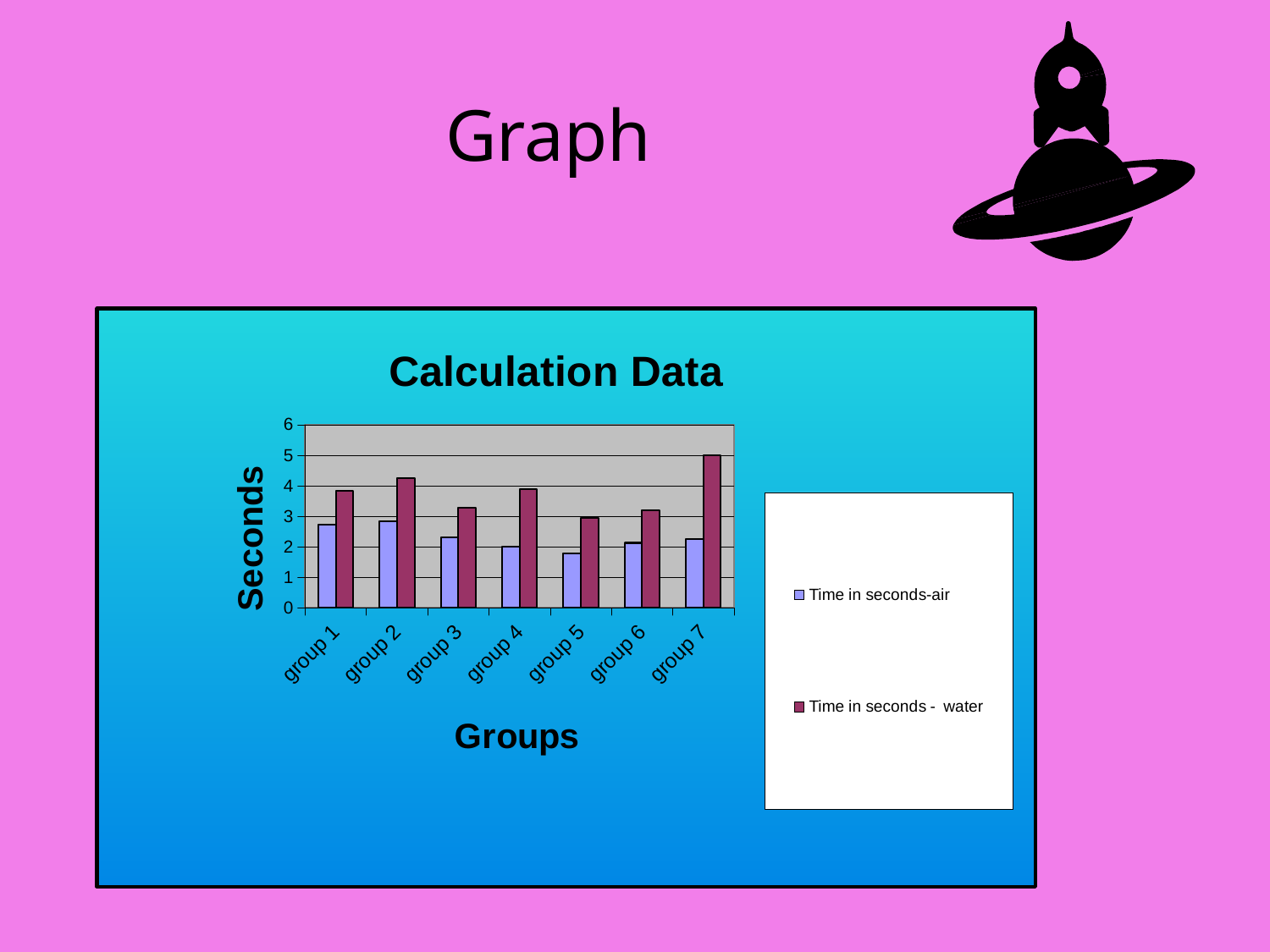
What is the label of the y axis? Seconds Is the value for Time in seconds-air for group 5 greater or less than 2? less For group 4, which is larger: Time in seconds-air or Time in seconds - water? Time in seconds - water Is the value for Time in seconds - water for group 7 greater or less than 4? greater How many groups are shown on the x axis? 7 Which group has the lowest value for Time in seconds - water? group 5 Which group has the lowest value for Time in seconds-air? group 5 How many series does the legend list? 2 What is the title of the chart? Calculation Data Is the value for Time in seconds-air for group 1 greater or less than 3? less What kind of chart is shown on the slide? bar chart Which group has the highest value for Time in seconds - water? group 7